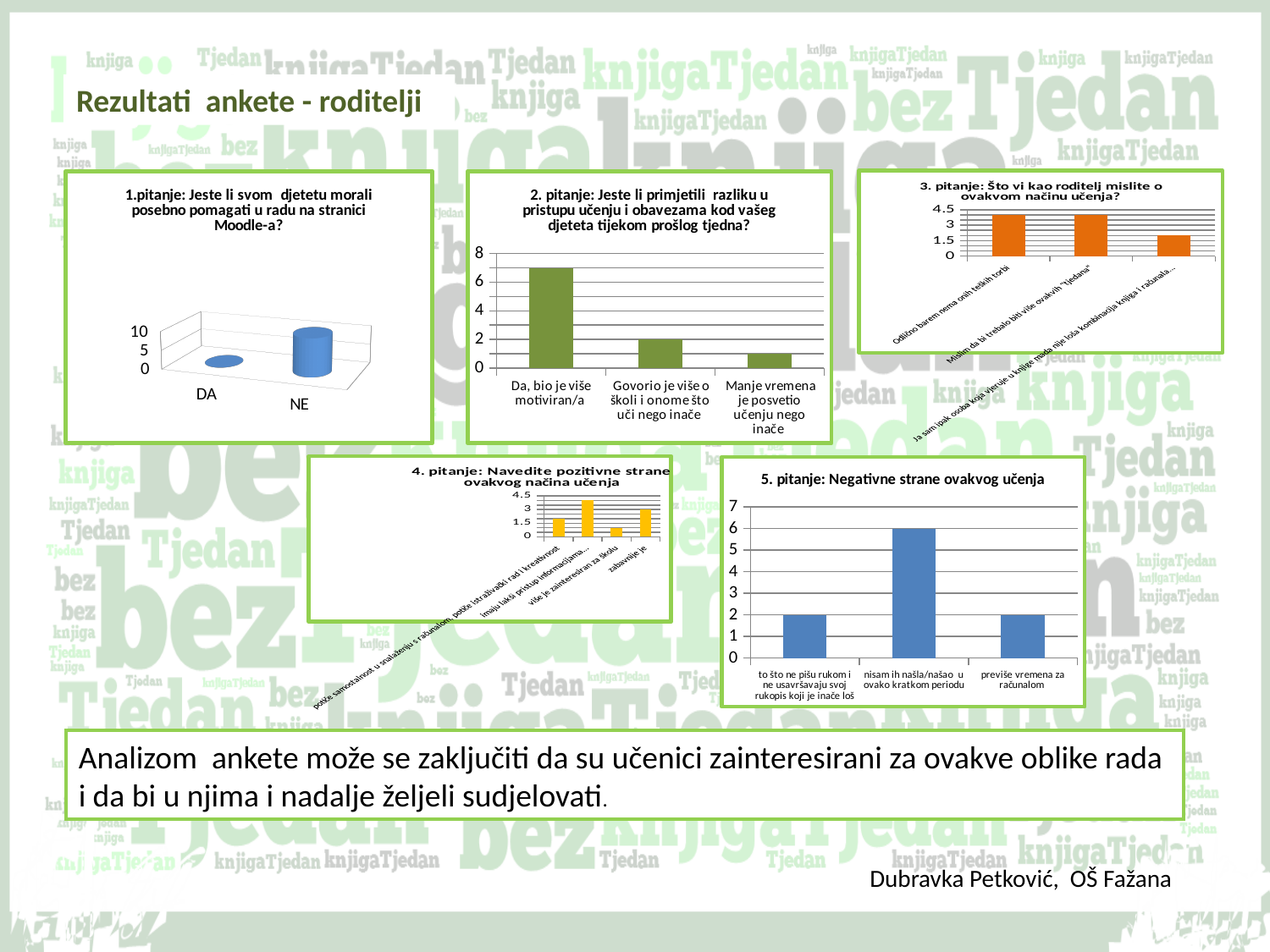
In the chart '5. pitanje: Negativne strane ovakvog učenja', what is the value for 'previše vremena za računalom'? 2 In the chart '5. pitanje: Negativne strane ovakvog učenja', which category has the highest value? nisam ih našla/našao u ovako kratkom periodu In the chart '2. pitanje: Jeste li primjetili razliku u pristupu učenju i obavezama kod vašeg djeteta tijekom prošlog tjedna?', which category has the highest value? Da, bio je više motiviran/a In the chart '1.pitanje: Jeste li svom djetetu morali posebno pomagati u radu na stranici Moodle-a?', is the value for NE greater or less than 5? greater In the chart '2. pitanje: Jeste li primjetili razliku u pristupu učenju i obavezama kod vašeg djeteta tijekom prošlog tjedna?', how many categories are shown? 3 In the chart '1.pitanje: Jeste li svom djetetu morali posebno pomagati u radu na stranici Moodle-a?', which category has the larger value, DA or NE? NE In the chart '5. pitanje: Negativne strane ovakvog učenja', what is the difference between 'nisam ih našla/našao u ovako kratkom periodu' and 'to što ne pišu rukom i ne usavršavaju svoj rukopis koji je inače loš'? 4 In the chart '2. pitanje: Jeste li primjetili razliku u pristupu učenju i obavezama kod vašeg djeteta tijekom prošlog tjedna?', which category has the lowest value? Manje vremena je posvetio učenju nego inače In the chart '3. pitanje: Što vi kao roditelj mislite o ovakvom načinu učenja?', is the value for 'Odlično barem nema onih teških torbi' greater or less than 3? greater In the chart '2. pitanje: Jeste li primjetili razliku u pristupu učenju i obavezama kod vašeg djeteta tijekom prošlog tjedna?', is the value for 'Da, bio je više motiviran/a' greater or less than 6? greater In the chart '5. pitanje: Negativne strane ovakvog učenja', what is the value for 'nisam ih našla/našao u ovako kratkom periodu'? 6 What kind of chart is '5. pitanje: Negativne strane ovakvog učenja'? bar chart